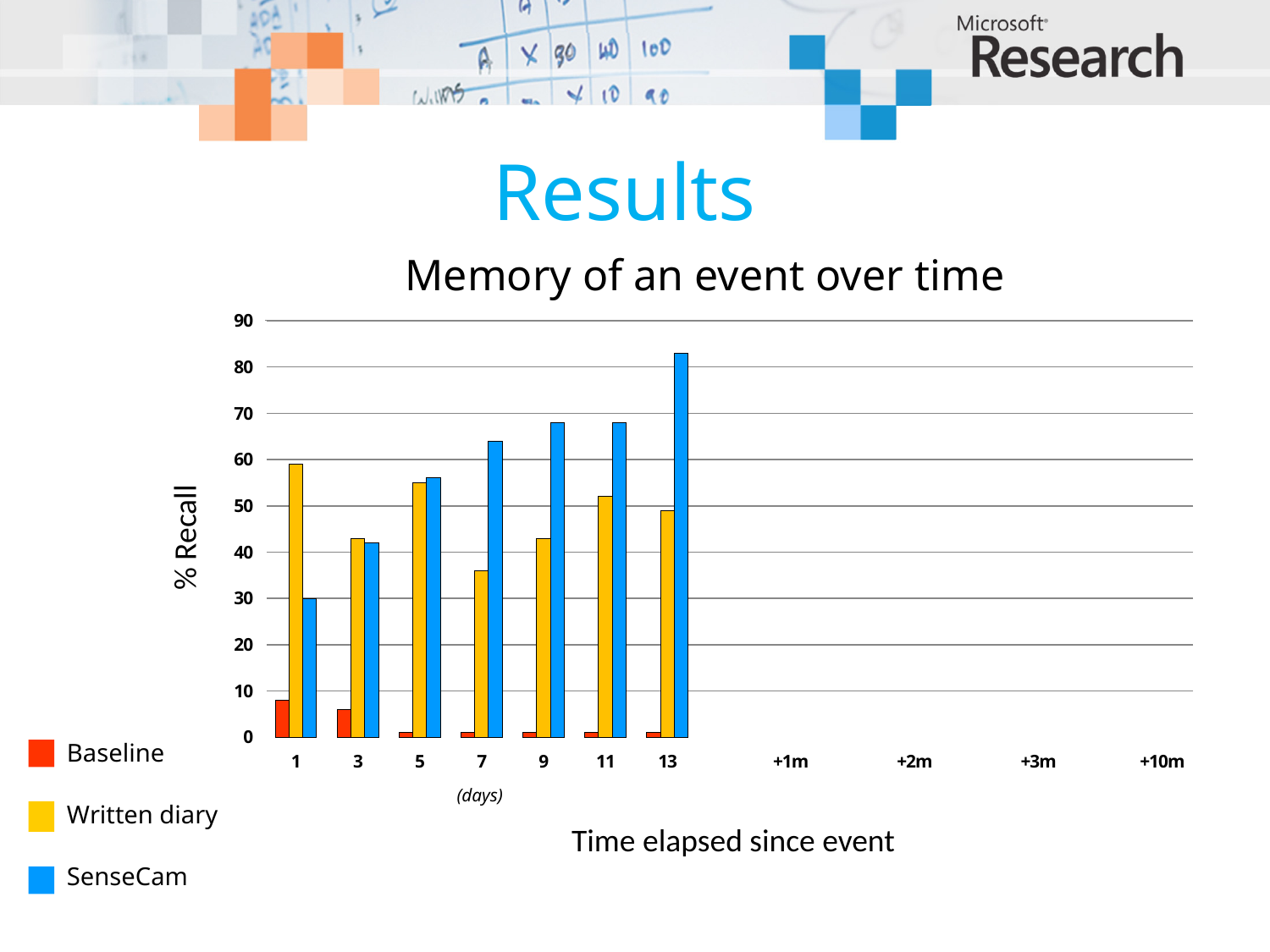
At which day does the SenseCam series reach its highest value? 13 What are the three series named in the legend of the "Memory of an event over time" chart? Baseline, Written diary, SenseCam Is the SenseCam value at day 1 greater or less than 40? less How many categories are labelled along the x axis of the "Memory of an event over time" chart? 11 What is the label on the vertical axis of the "Memory of an event over time" chart? % Recall At day 7, which is larger: the Written diary value or the SenseCam value? SenseCam Is the Written diary value at day 1 greater or less than 50? greater Is the Baseline value at day 1 greater or less than 10? less What kind of chart is shown under the title "Memory of an event over time"? bar chart At day 1, which is larger: the Written diary value or the SenseCam value? Written diary How many series does the legend of the "Memory of an event over time" chart list? 3